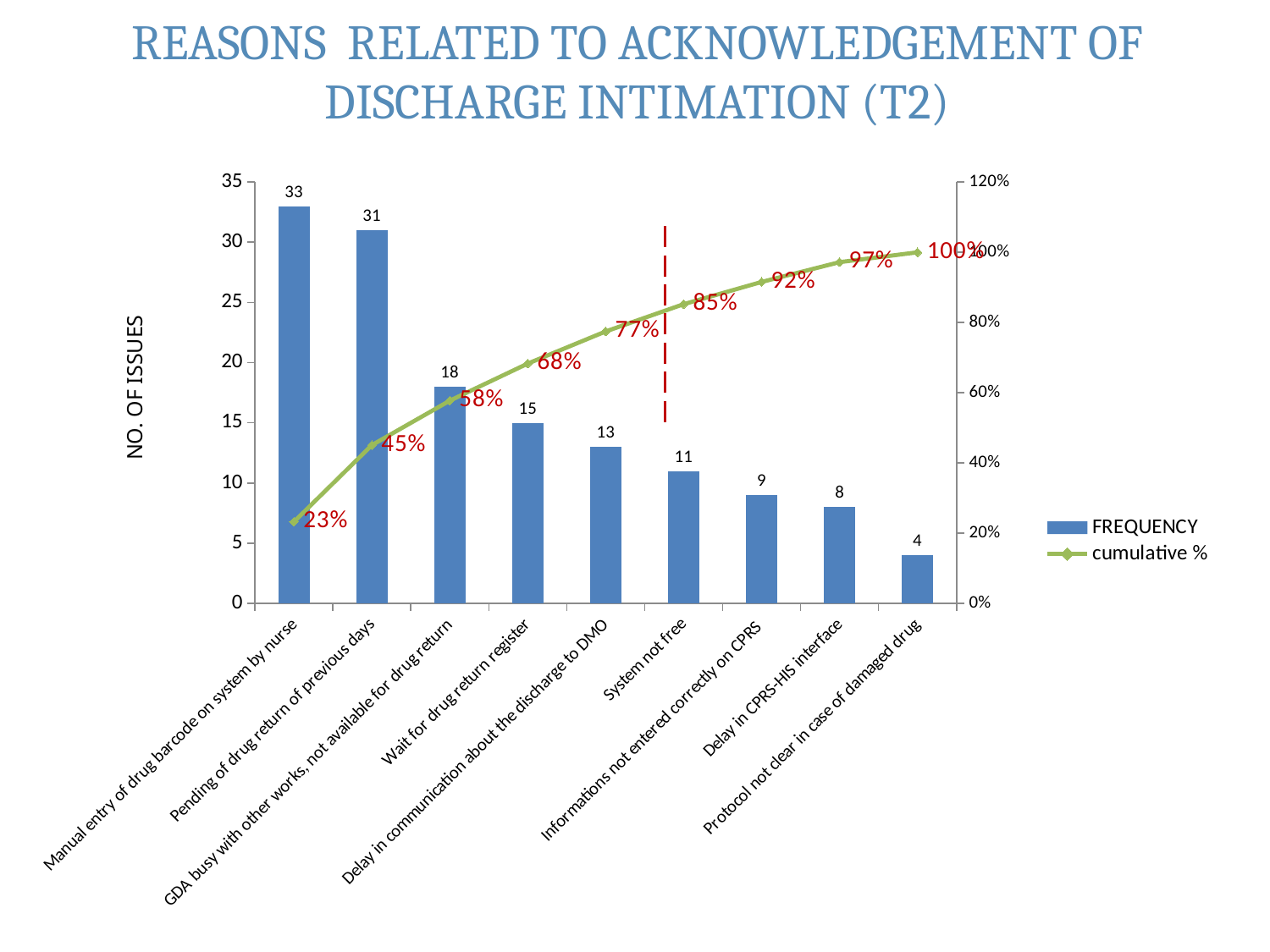
Do the frequency values rise or fall from left to right along the x axis? Fall What is the cumulative % at "Wait for drug return register"? 68% Which category has the lowest frequency? Protocol not clear in case of damaged drug How many series does the legend list? 2 Which category has the highest frequency? Manual entry of drug barcode on system by nurse What is the difference in frequency between "Pending of drug return of previous days" and "GDA busy with other works, not available for drug return"? 13 Which has a higher frequency, "Delay in CPRS-HIS interface" or "Informations not entered correctly on CPRS"? Informations not entered correctly on CPRS What is the frequency for "System not free"? 11 What is the frequency for "Manual entry of drug barcode on system by nurse"? 33 What kind of chart is this? Bar chart with a cumulative % line (Pareto chart) What is the label of the left vertical axis? NO. OF ISSUES How many categories are shown on the x axis? 9